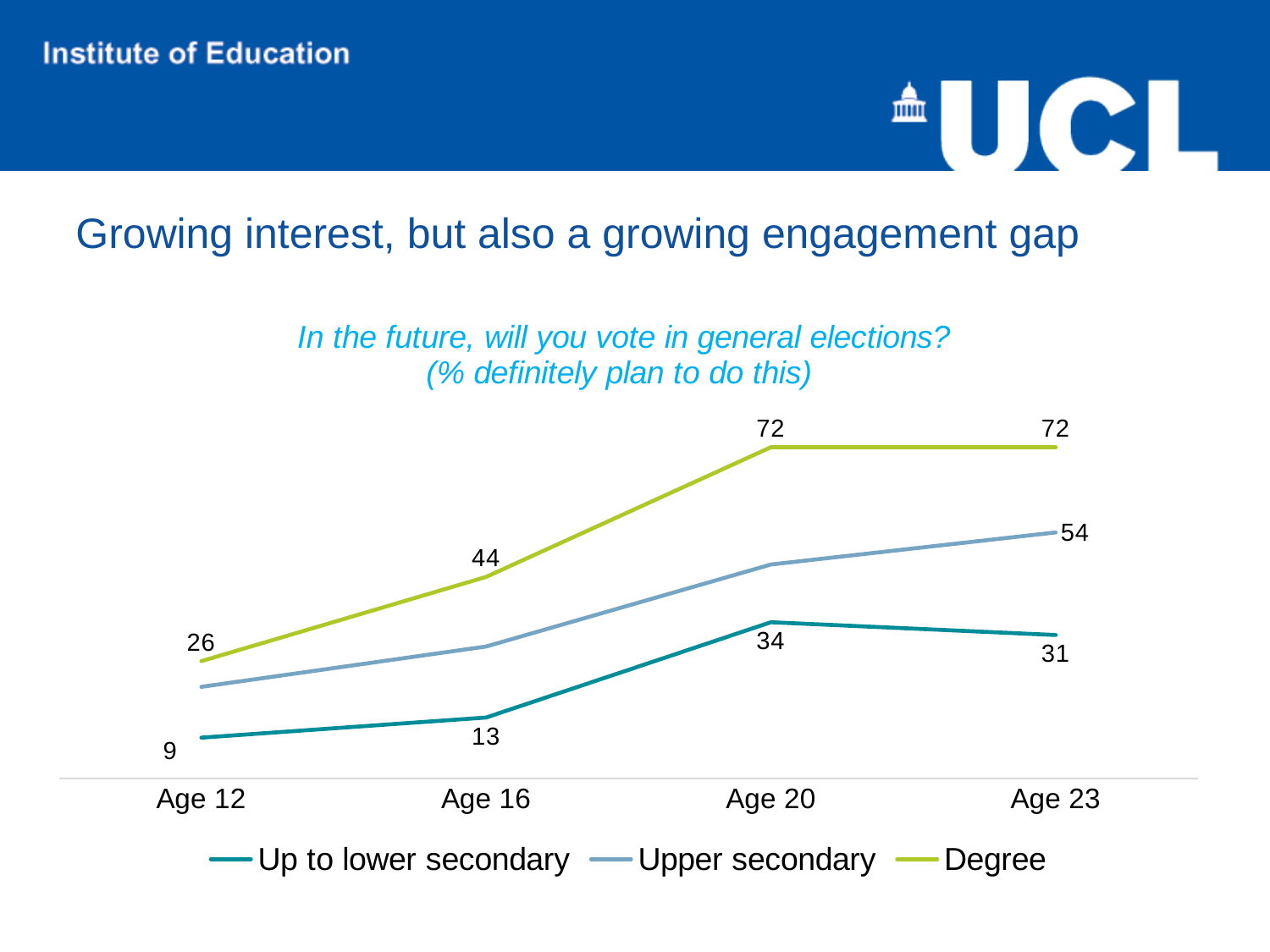
What is the difference between the Degree and Up to lower secondary values at Age 23? 41 How many series does the legend list? 3 What is the value for the Upper secondary series at Age 23? 54 What is the value for the Degree series at Age 16? 44 Does the Degree series rise or fall from Age 12 to Age 20? rise Which series has the highest value at Age 23? Degree What is the value for the Up to lower secondary series at Age 12? 9 What kind of chart is shown on the slide? line chart How many age points are shown on the x axis? 4 Which is larger at Age 16: the Degree value or the Up to lower secondary value? Degree What is the value for the Up to lower secondary series at Age 20? 34 At which age is the Up to lower secondary series lowest? Age 12